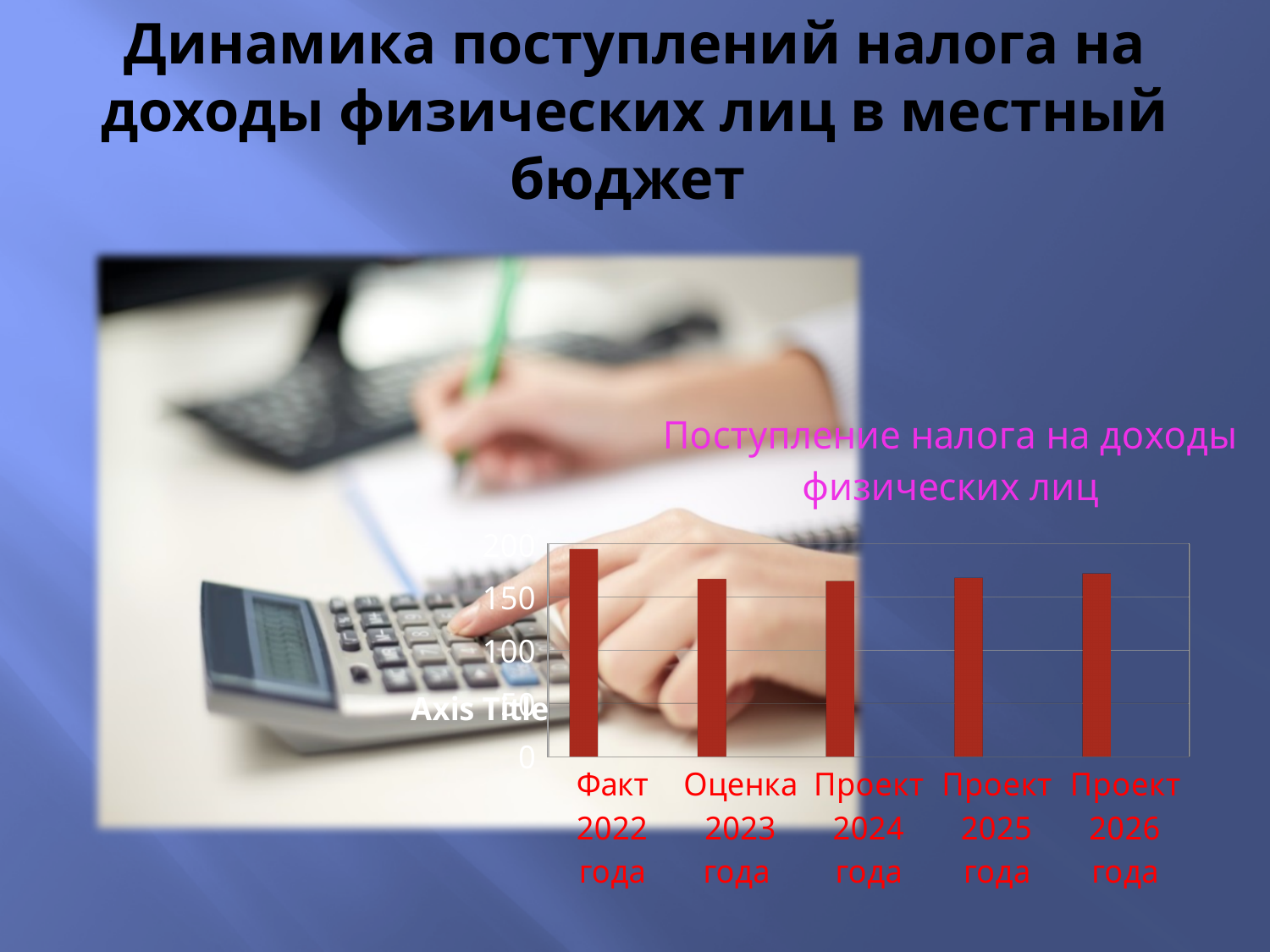
Is the value for Проект 2024 года greater or less than 200? less Which is larger, the value for Факт 2022 года or the value for Проект 2026 года? Факт 2022 года Is the value for Факт 2022 года greater or less than 150? greater Which category has the highest value in the chart? Факт 2022 года Is the value for Проект 2026 года greater or less than 100? greater What colour are the bars in the chart? red What is the title of the chart? Поступление налога на доходы физических лиц Does the value rise or fall from Факт 2022 года to Оценка 2023 года? fall What kind of chart is shown on the slide? bar chart Which is larger, the value for Факт 2022 года or the value for Оценка 2023 года? Факт 2022 года How many categories are shown on the x axis of the chart? 5